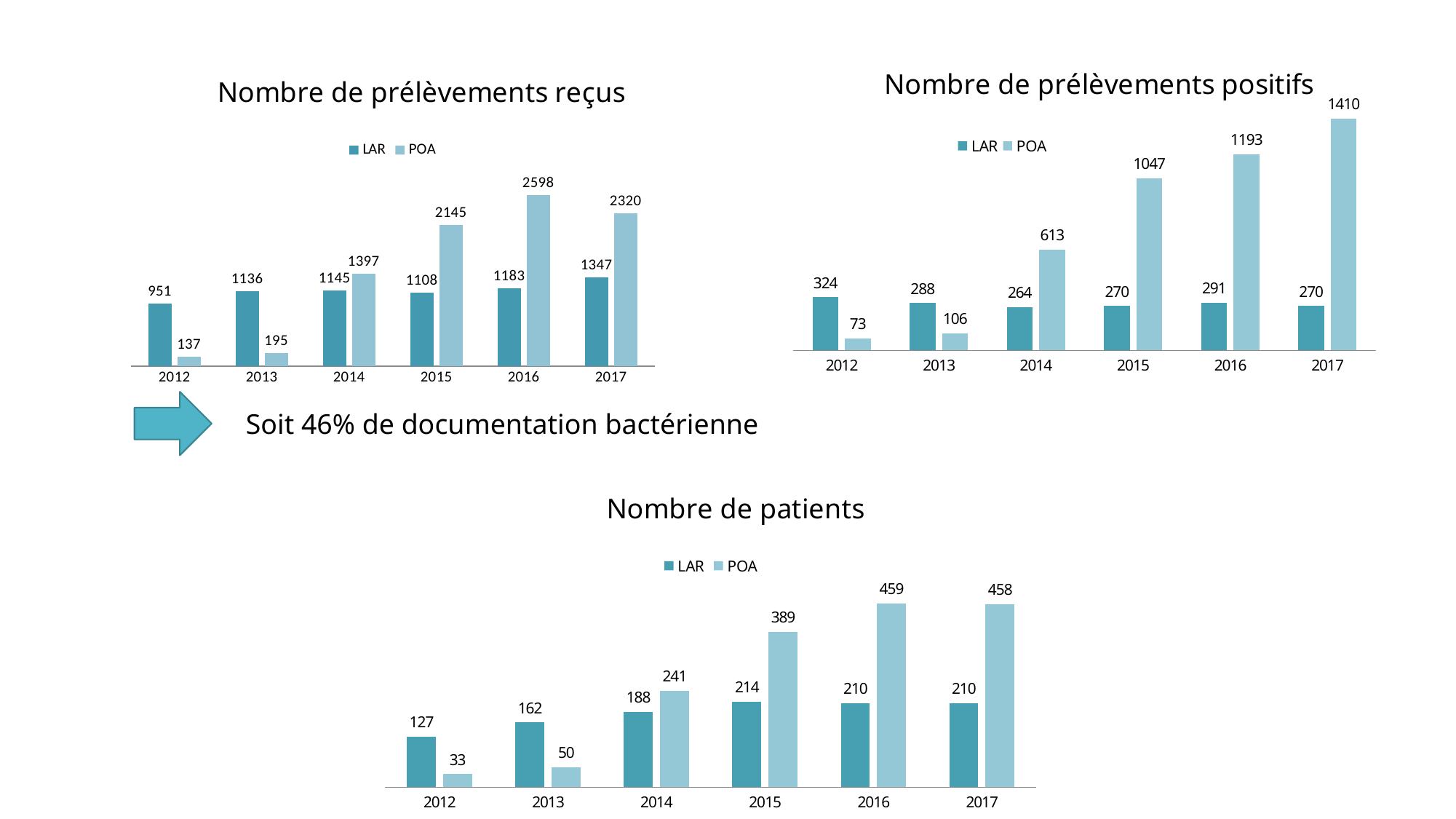
In the 'Nombre de patients' chart, how many series does the legend list? 2 In the 'Nombre de patients' chart, how many years are shown on the x axis? 6 In the 'Nombre de prélèvements reçus' chart, what is the difference between POA and LAR in 2017? 973 In the 'Nombre de patients' chart, what is the value for POA in 2015? 389 In the 'Nombre de prélèvements positifs' chart, which year has the lowest POA value? 2012 In the 'Nombre de prélèvements reçus' chart, what is the value for LAR in 2012? 951 In the 'Nombre de prélèvements reçus' chart, which year has the highest POA value? 2016 In the 'Nombre de prélèvements positifs' chart, which is larger in 2013, LAR or POA? LAR In the 'Nombre de prélèvements positifs' chart, what is the value for POA in 2017? 1410 What kind of chart is 'Nombre de patients'? Bar chart In the 'Nombre de prélèvements reçus' chart, what is the value for POA in 2016? 2598 In the 'Nombre de prélèvements positifs' chart, what is the difference between LAR in 2012 and LAR in 2017? 54